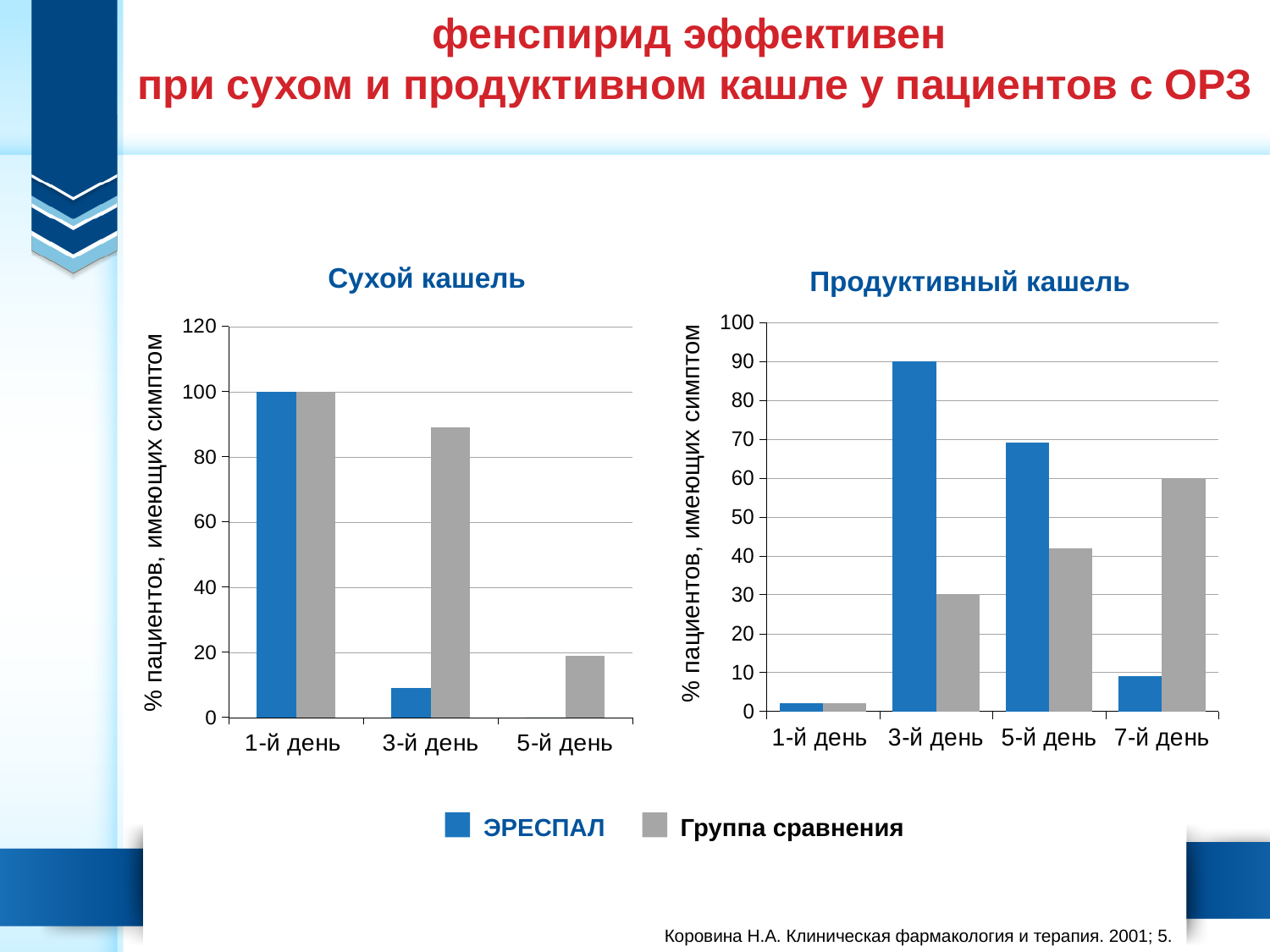
In the "Продуктивный кашель" chart, what is the value for Группа сравнения on 3-й день? 30 How many series does the legend list for the charts? 2 In the "Сухой кашель" chart, do the ЭРЕСПАЛ values rise or fall from 1-й день to 5-й день? fall In the "Продуктивный кашель" chart, what is the value for ЭРЕСПАЛ on 3-й день? 90 In the "Продуктивный кашель" chart, on which day is the ЭРЕСПАЛ value highest? 3-й день In the "Продуктивный кашель" chart, what is the difference between ЭРЕСПАЛ and Группа сравнения on 3-й день? 60 In the "Сухой кашель" chart, is the value for Группа сравнения on 3-й день greater or less than 80? greater In the "Продуктивный кашель" chart, which series has the larger value on 5-й день, ЭРЕСПАЛ or Группа сравнения? ЭРЕСПАЛ What kind of chart is the "Сухой кашель" chart? bar chart How many day categories are shown on the x axis of the "Продуктивный кашель" chart? 4 In the "Продуктивный кашель" chart, what is the value for Группа сравнения on 7-й день? 60 In the "Сухой кашель" chart, what is the value for ЭРЕСПАЛ on 1-й день? 100